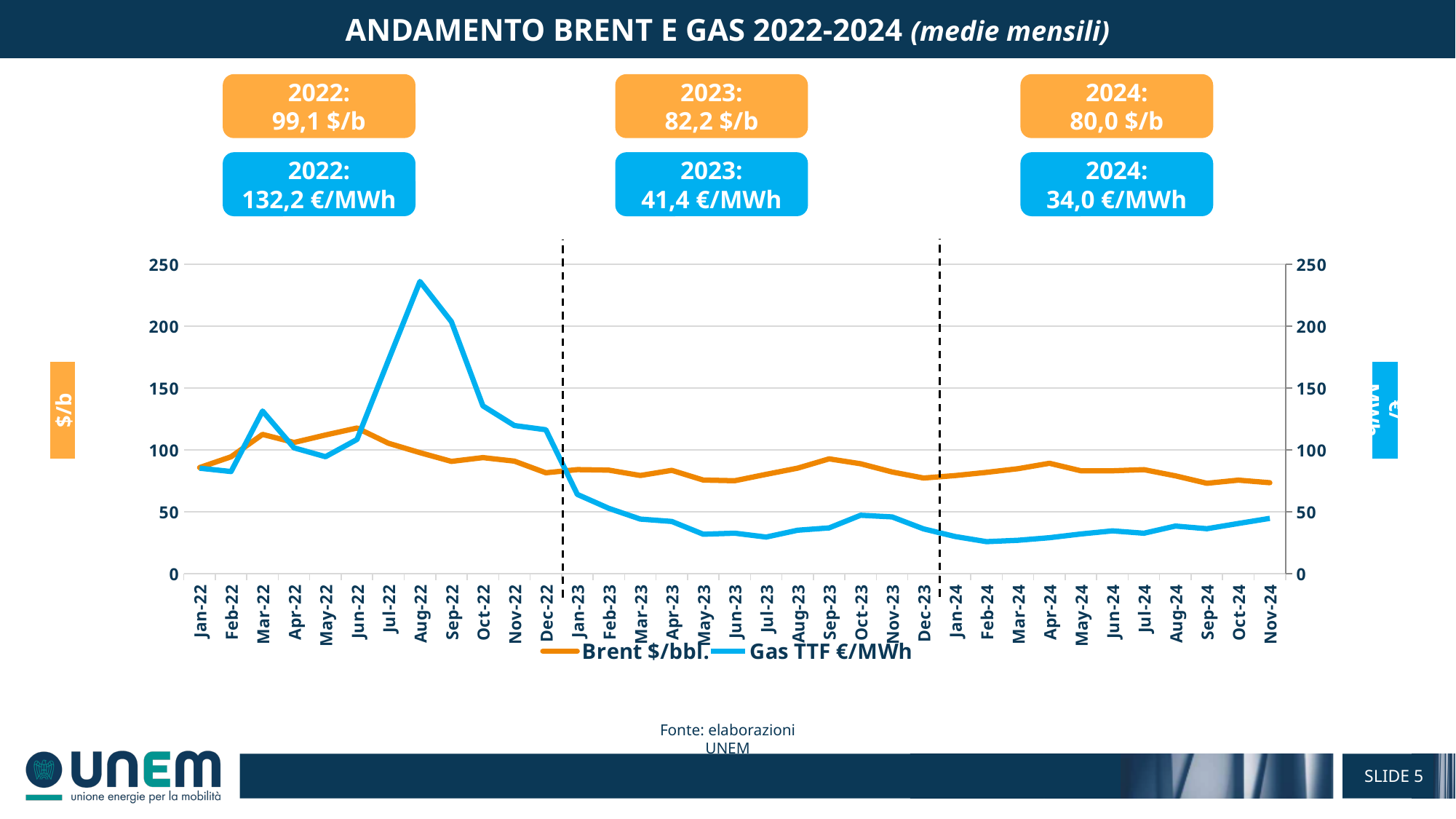
What is the 2024 annual average for Brent shown in the orange box? 80,0 $/b What is the 2022 annual average for Brent shown in the orange box? 99,1 $/b What is the 2023 annual average for Gas TTF shown in the blue box? 41,4 €/MWh In which month does the Gas TTF line reach its highest value? Aug-22 Which annual average for Gas TTF is larger, 2022 or 2024? 2022 Is the Gas TTF value for Aug-22 greater or less than 200? greater Does the Gas TTF line rise or fall between Aug-22 and Dec-22? fall What is the difference between the 2022 and 2023 annual averages for Brent shown in the orange boxes? 16,9 $/b What type of chart is shown on the slide? line chart What is the difference between the 2022 and 2023 annual averages for Gas TTF shown in the blue boxes? 90,8 €/MWh How many series does the legend list? 2 Is the Gas TTF value for Feb-24 greater or less than 50? less